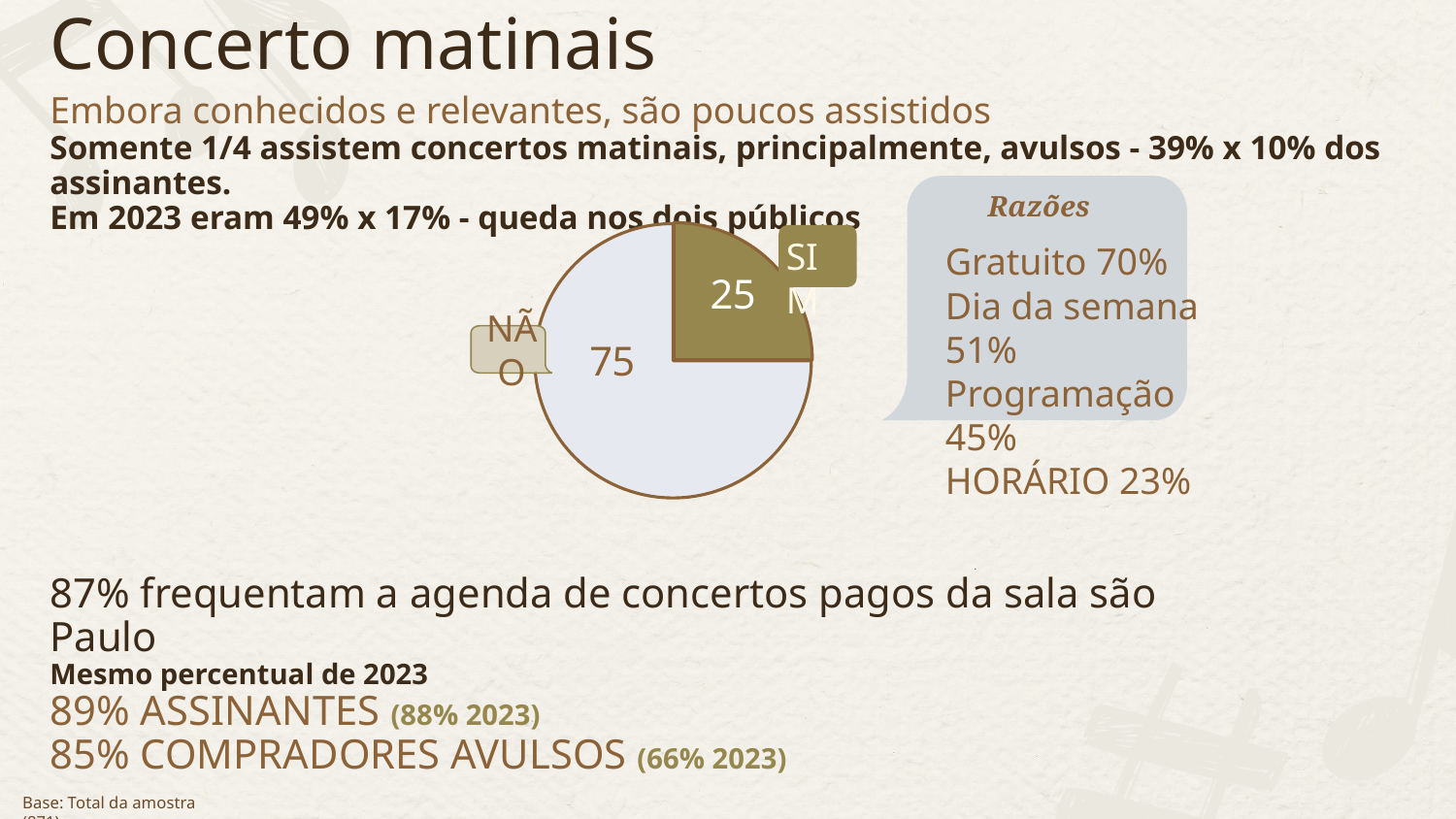
What share of the pie does the NÃO slice represent? 75% Which is larger in the pie chart, SIM or NÃO? NÃO What share of the pie does the SIM slice represent? 25% Which slice of the pie chart is the smallest? SIM What is the difference between the NÃO and SIM values in the pie chart? 50 What kind of chart is shown on the slide? pie chart Which slice of the pie chart is the largest? NÃO What is the value of the SIM slice in the pie chart? 25 What colour is the SIM slice in the pie chart? olive/brown How many slices does the pie chart have? 2 What is the value of the NÃO slice in the pie chart? 75 What is the total of the two slice values in the pie chart? 100